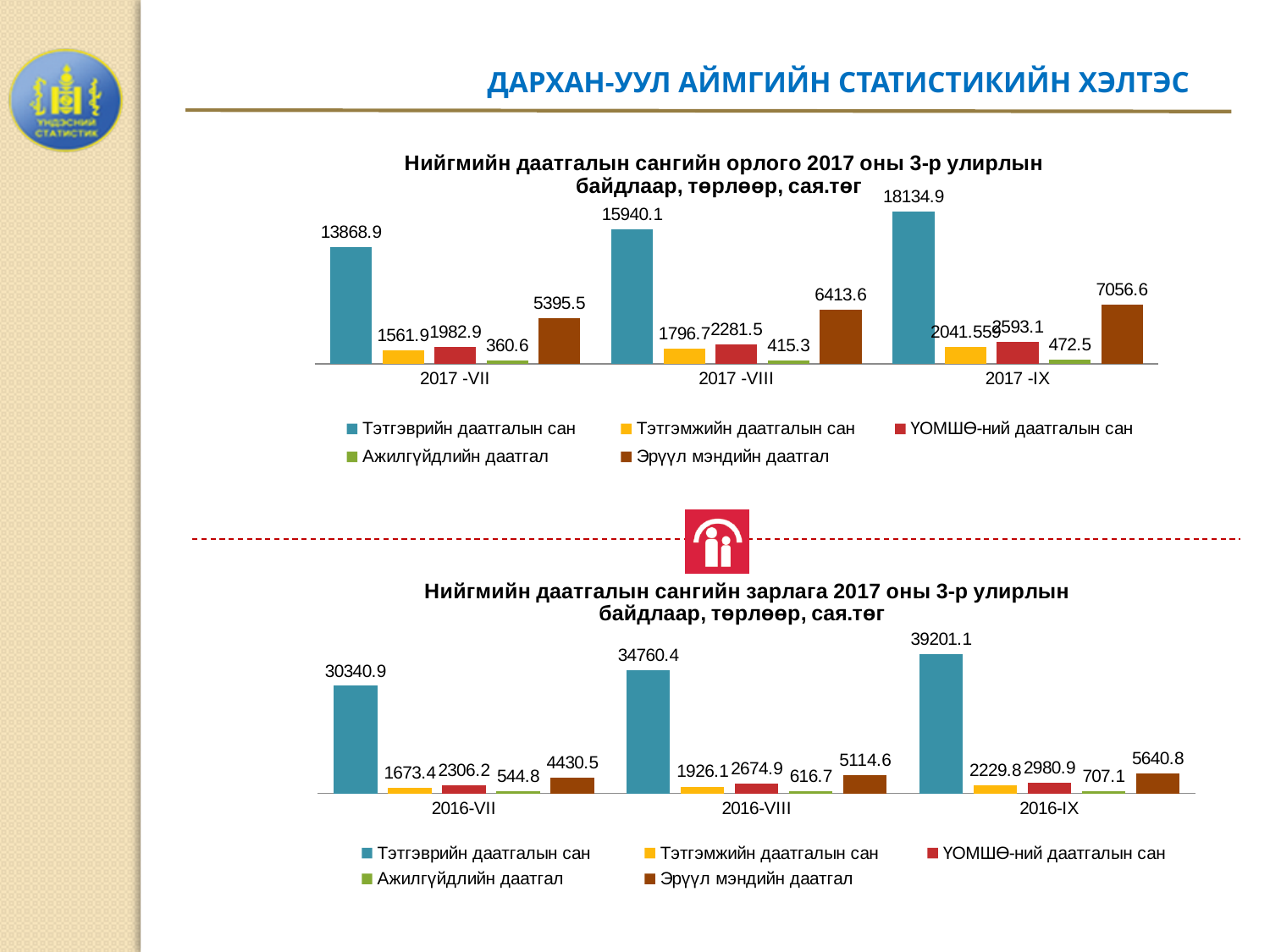
In the top chart (Нийгмийн даатгалын сангийн орлого), what is the value of Ажилгүйдлийн даатгал for 2017 -VIII? 415.3 In the bottom chart (Нийгмийн даатгалын сангийн зарлага), which is larger: Эрүүл мэндийн даатгал for 2016-IX or Тэтгэмжийн даатгалын сан for 2016-IX? Эрүүл мэндийн даатгал for 2016-IX In the top chart (Нийгмийн даатгалын сангийн орлого), what is the value of Тэтгэврийн даатгалын сан for 2017 -VII? 13868.9 What type of chart is the bottom chart (Нийгмийн даатгалын сангийн зарлага)? bar chart How many series does the legend of the top chart (Нийгмийн даатгалын сангийн орлого) list? 5 In the top chart (Нийгмийн даатгалын сангийн орлого), what is the value of Эрүүл мэндийн даатгал for 2017 -IX? 7056.6 In the bottom chart (Нийгмийн даатгалын сангийн зарлага), which period has the lowest value for Ажилгүйдлийн даатгал? 2016-VII In the bottom chart (Нийгмийн даатгалын сангийн зарлага), what is the value of Тэтгэврийн даатгалын сан for 2016-IX? 39201.1 In the top chart (Нийгмийн даатгалын сангийн орлого), what is the difference between the Тэтгэврийн даатгалын сан values for 2017 -IX and 2017 -VII? 4266.0 In the bottom chart (Нийгмийн даатгалын сангийн зарлага), what is the value of ҮОМШӨ-ний даатгалын сан for 2016-VIII? 2674.9 In the top chart (Нийгмийн даатгалын сангийн орлого), which period has the highest value for Тэтгэврийн даатгалын сан? 2017 -IX In the top chart (Нийгмийн даатгалын сангийн орлого), does the value of Тэтгэврийн даатгалын сан rise or fall from 2017 -VII to 2017 -IX? rise